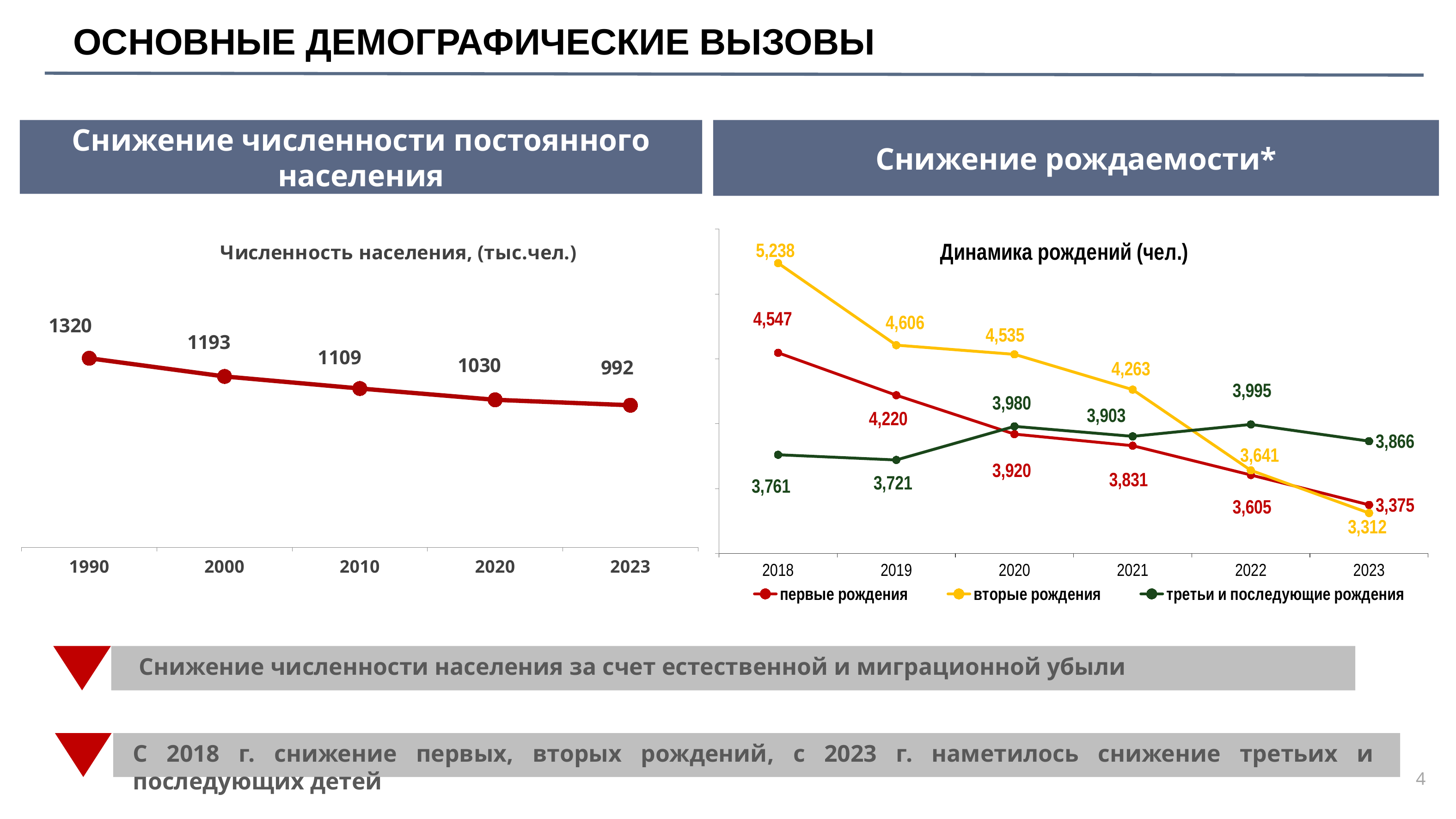
In the chart 'Численность населения, (тыс.чел.)', what is the value for 2023? 992 In the chart 'Динамика рождений (чел.)', what is the difference between the 'первые рождения' values for 2018 and 2023? 1,172 In the chart 'Динамика рождений (чел.)', what is the value for 'вторые рождения' in 2018? 5,238 In the chart 'Численность населения, (тыс.чел.)', which year has the highest value? 1990 In the chart 'Численность населения, (тыс.чел.)', what is the difference between the 1990 and 2023 values? 328 In the chart 'Динамика рождений (чел.)', how many series does the legend list? 3 In the chart 'Динамика рождений (чел.)', what is the value for 'третьи и последующие рождения' in 2022? 3,995 In the chart 'Динамика рождений (чел.)', which series has the lowest value in 2023? вторые рождения In the chart 'Численность населения, (тыс.чел.)', what is the value for 2010? 1109 In the chart 'Динамика рождений (чел.)', which is larger in 2021: 'первые рождения' or 'третьи и последующие рождения'? третьи и последующие рождения In the chart 'Численность населения, (тыс.чел.)', how many data points are plotted? 5 In the chart 'Численность населения, (тыс.чел.)', do the values rise or fall from 1990 to 2023? fall